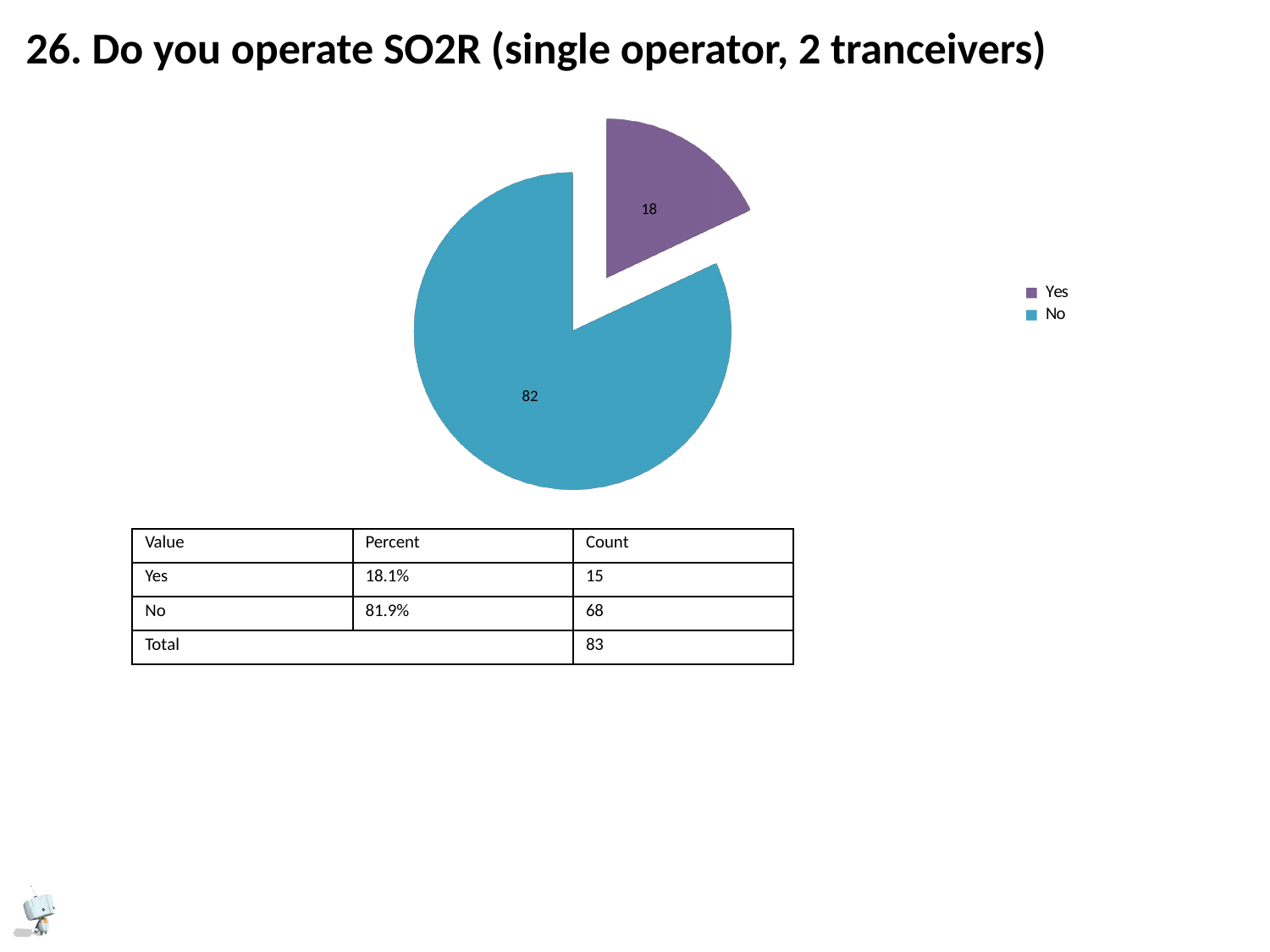
Which slice of the pie chart is pulled out (exploded) from the rest of the pie? Yes How many slices does the pie chart have? 2 What kind of chart is shown on the slide? pie chart What is the title of the slide containing the pie chart? 26. Do you operate SO2R (single operator, 2 tranceivers) What is the data label shown on the No slice of the pie chart? 82 How many entries does the legend of the pie chart list? 2 What is the difference between the data labels of the No slice and the Yes slice in the pie chart? 64 Which is larger in the pie chart, the Yes slice or the No slice? No Which slice of the pie chart is the smallest? Yes Which slice of the pie chart is the largest? No What is the data label shown on the Yes slice of the pie chart? 18 What colour is the No slice in the pie chart? blue